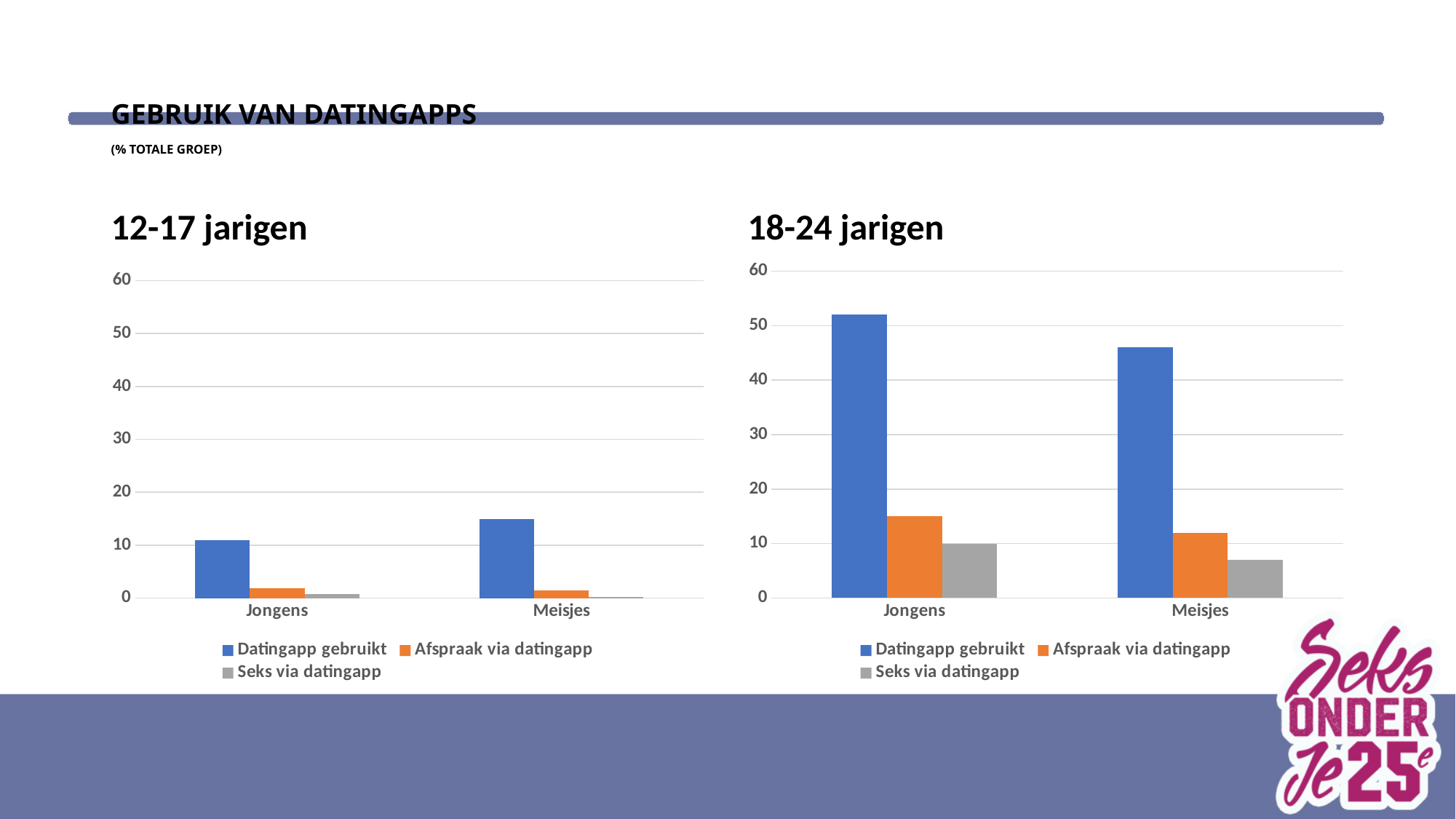
In the '18-24 jarigen' chart, which series has the highest value for Jongens? Datingapp gebruikt How many series does the legend of the '18-24 jarigen' chart list? 3 In the '12-17 jarigen' chart, which group has the higher value for 'Datingapp gebruikt', Jongens or Meisjes? Meisjes In the '18-24 jarigen' chart, which series has the lowest value for Meisjes? Seks via datingapp In the '18-24 jarigen' chart, is the value for 'Datingapp gebruikt' for Meisjes greater or less than 50? less How many categories are shown on the x axis of the '12-17 jarigen' chart? 2 What kind of chart is the '12-17 jarigen' chart? bar chart What is the title of the slide above the two charts? GEBRUIK VAN DATINGAPPS In the '18-24 jarigen' chart, which group has the higher value for 'Datingapp gebruikt', Jongens or Meisjes? Jongens In the '12-17 jarigen' chart, is the value for 'Datingapp gebruikt' for Meisjes greater or less than 20? less In the '18-24 jarigen' chart, is the value for 'Datingapp gebruikt' for Jongens greater or less than 50? greater